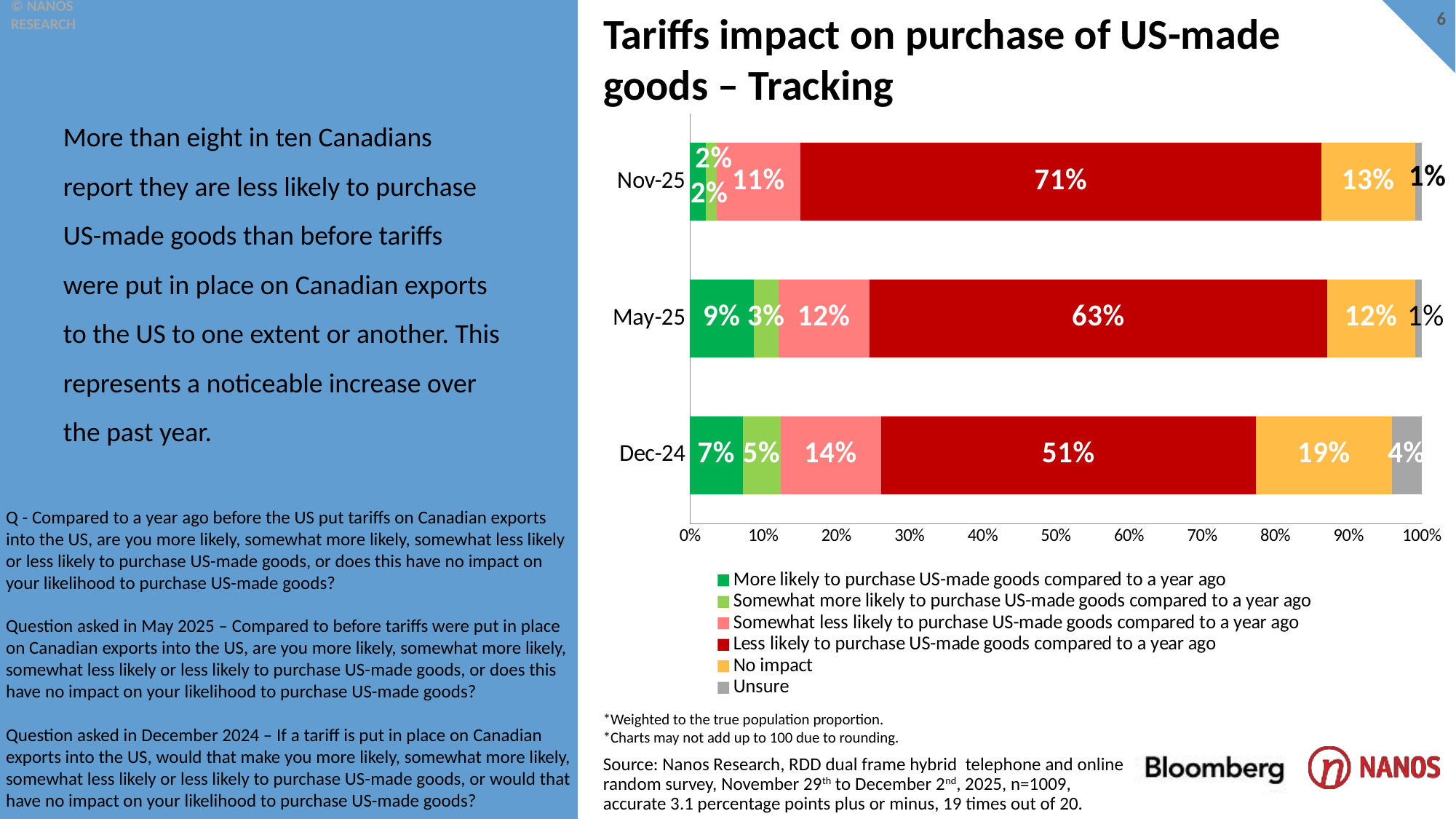
What kind of chart is shown on the slide? Stacked bar chart What percentage of respondents in Nov-25 said they are less likely to purchase US-made goods compared to a year ago? 71% Which time period has the lowest 'No impact' value? May-25 Which time period has the highest 'Less likely to purchase US-made goods' value? Nov-25 Is the 'Somewhat less likely' value larger for Dec-24 or Nov-25? Dec-24 How many series does the legend list? 6 What is the 'No impact' value for Dec-24? 19% What is the difference between the 'Less likely' values for Nov-25 and Dec-24? 20 percentage points Does the 'Less likely to purchase US-made goods' value rise or fall from Dec-24 to Nov-25? Rise What is the 'More likely to purchase US-made goods' value for May-25? 9% What is the 'Unsure' value for Dec-24? 4% How many time periods (bars) are shown in the chart? 3